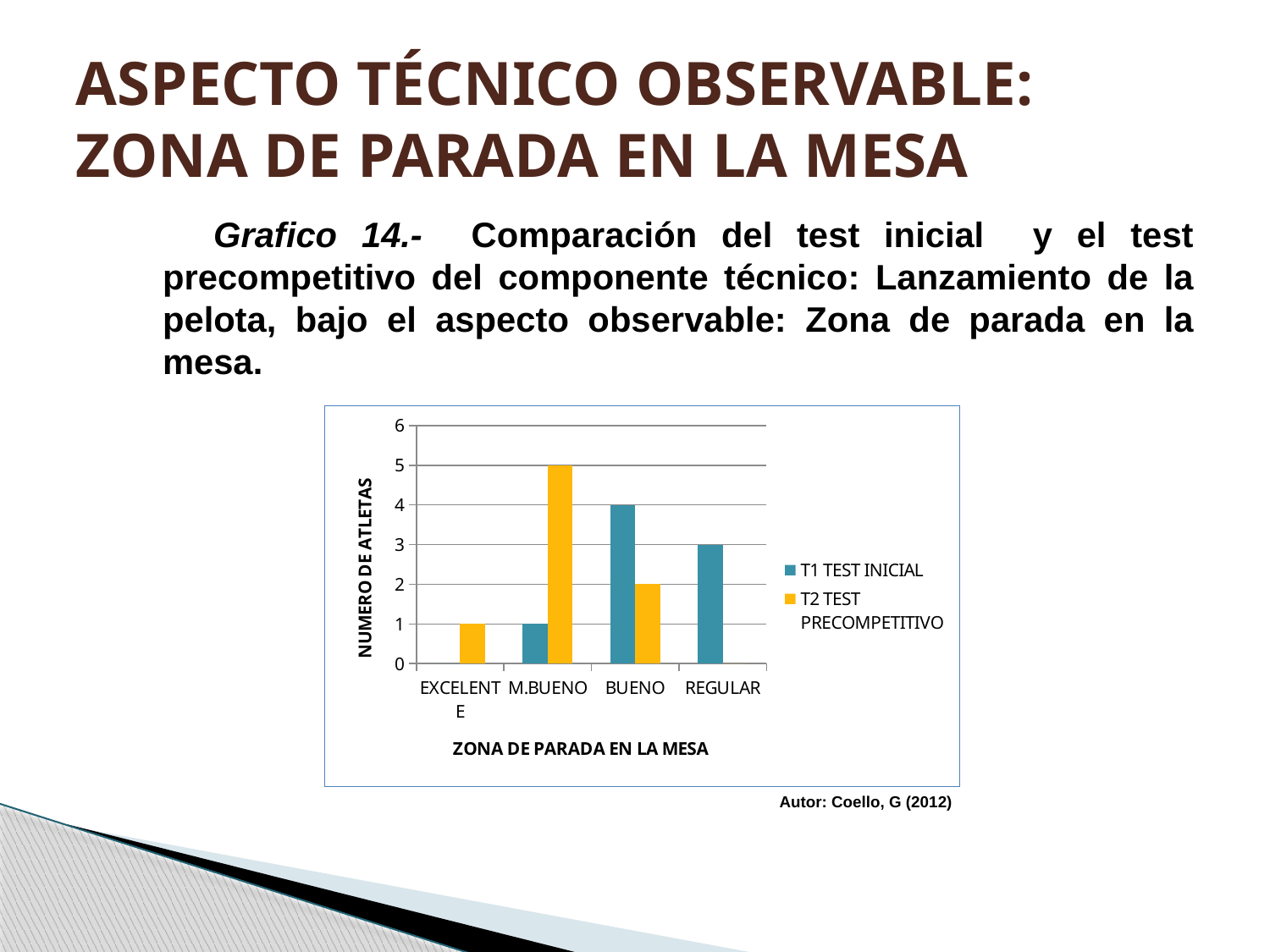
What is the label of the y axis? NUMERO DE ATLETAS Which category has the highest value in the T2 TEST PRECOMPETITIVO series? M.BUENO What is the value for REGULAR in the T1 TEST INICIAL series? 3 For BUENO, which series has the larger value, T1 TEST INICIAL or T2 TEST PRECOMPETITIVO? T1 TEST INICIAL What kind of chart is shown on the slide? bar chart How many series does the legend list? 2 Which category has the highest value in the T1 TEST INICIAL series? BUENO What is the value for M.BUENO in the T2 TEST PRECOMPETITIVO series? 5 Is the value for M.BUENO in the T2 TEST PRECOMPETITIVO series greater or less than 4? greater What is the value for BUENO in the T1 TEST INICIAL series? 4 How many categories are shown on the x axis? 4 What is the difference between the T2 TEST PRECOMPETITIVO value and the T1 TEST INICIAL value for M.BUENO? 4